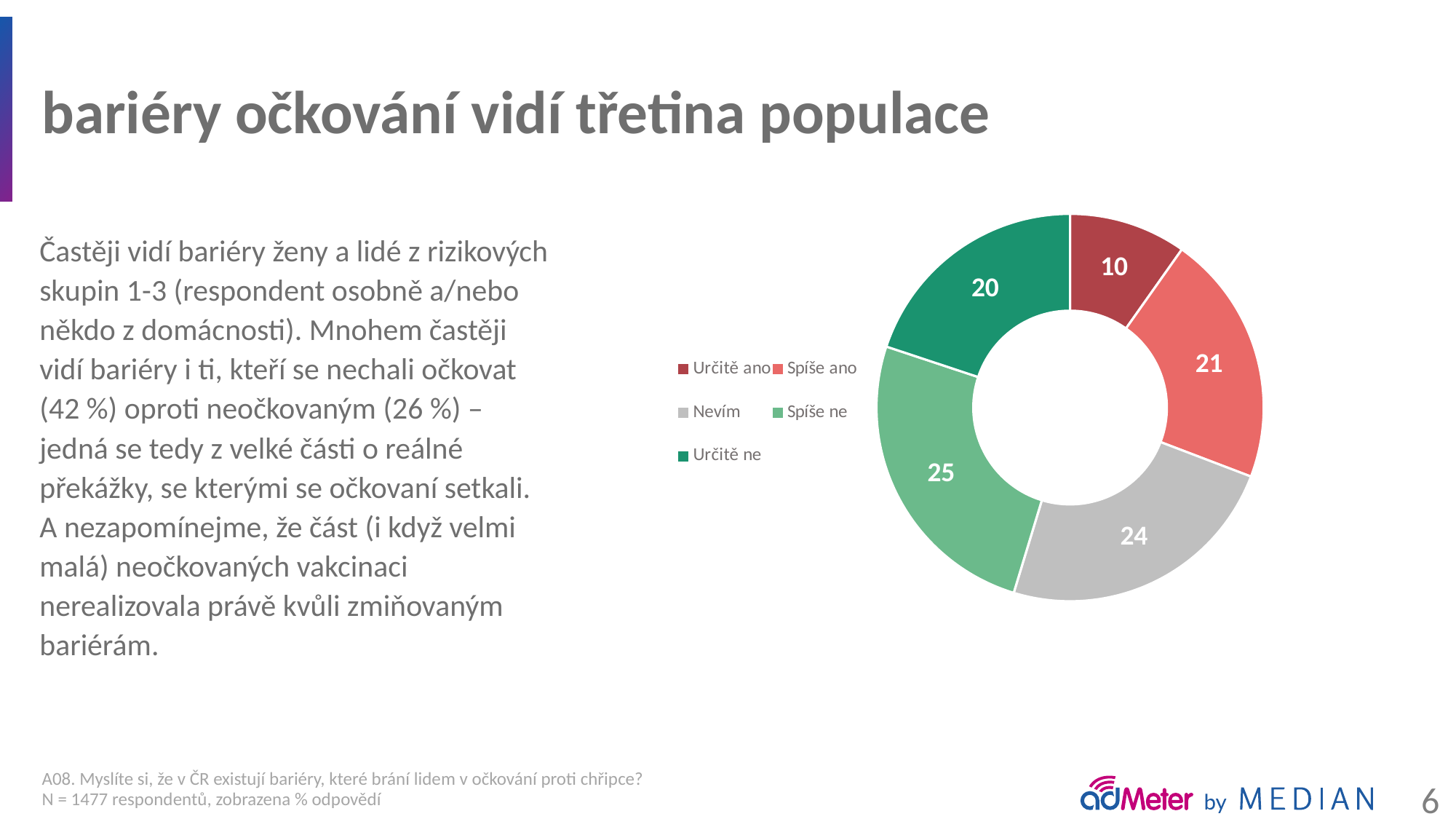
Which category has the largest value? Spíše ne How many categories does the chart show? 5 Which is larger, the value for "Spíše ano" or the value for "Určitě ne"? Spíše ano What is the difference between the values for "Spíše ne" and "Určitě ano"? 15 What is the value for "Nevím"? 24 What kind of chart is shown on the slide? doughnut chart What is the value for "Určitě ne"? 20 What is the value for "Určitě ano"? 10 What is the value for "Spíše ano"? 21 What is the value for "Spíše ne"? 25 How many entries does the legend list? 5 Which category has the smallest value? Určitě ano